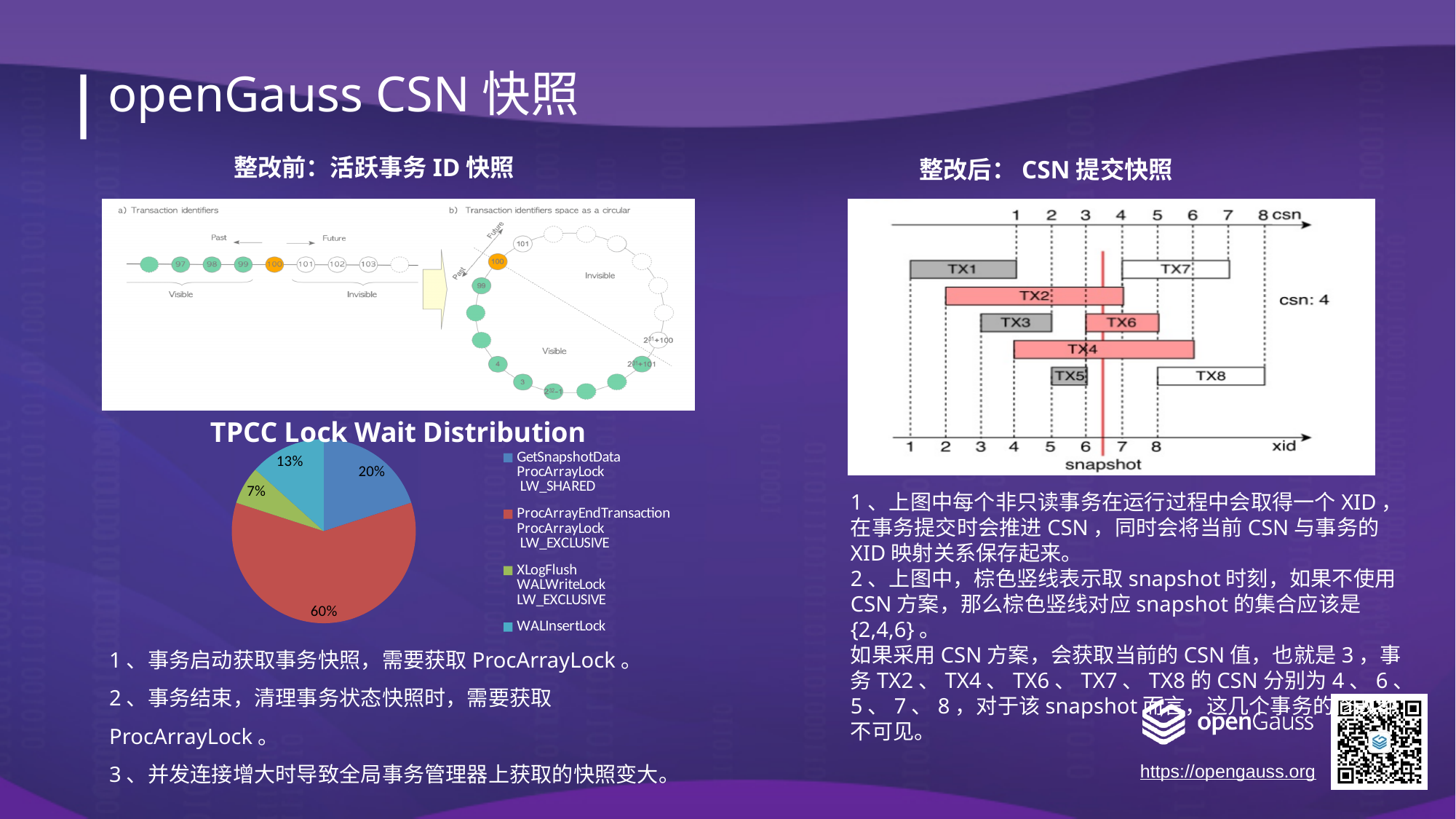
In the TPCC Lock Wait Distribution pie chart, what colour is the WALInsertLock slice? cyan In the TPCC Lock Wait Distribution pie chart, what share does ProcArrayEndTransaction ProcArrayLock LW_EXCLUSIVE have? 60% In the TPCC Lock Wait Distribution pie chart, what is the difference between the ProcArrayEndTransaction ProcArrayLock LW_EXCLUSIVE share and the GetSnapshotData ProcArrayLock LW_SHARED share? 40% In the TPCC Lock Wait Distribution pie chart, which category has the largest slice? ProcArrayEndTransaction ProcArrayLock LW_EXCLUSIVE What is the title of the pie chart on the slide? TPCC Lock Wait Distribution In the TPCC Lock Wait Distribution pie chart, what share does WALInsertLock have? 13% In the TPCC Lock Wait Distribution pie chart, how many categories does the legend list? 4 In the TPCC Lock Wait Distribution pie chart, what share does XLogFlush WALWriteLock LW_EXCLUSIVE have? 7% In the TPCC Lock Wait Distribution pie chart, which category has the smallest slice? XLogFlush WALWriteLock LW_EXCLUSIVE In the TPCC Lock Wait Distribution pie chart, which is larger: the WALInsertLock share or the XLogFlush WALWriteLock LW_EXCLUSIVE share? WALInsertLock What kind of chart is the TPCC Lock Wait Distribution chart? pie chart